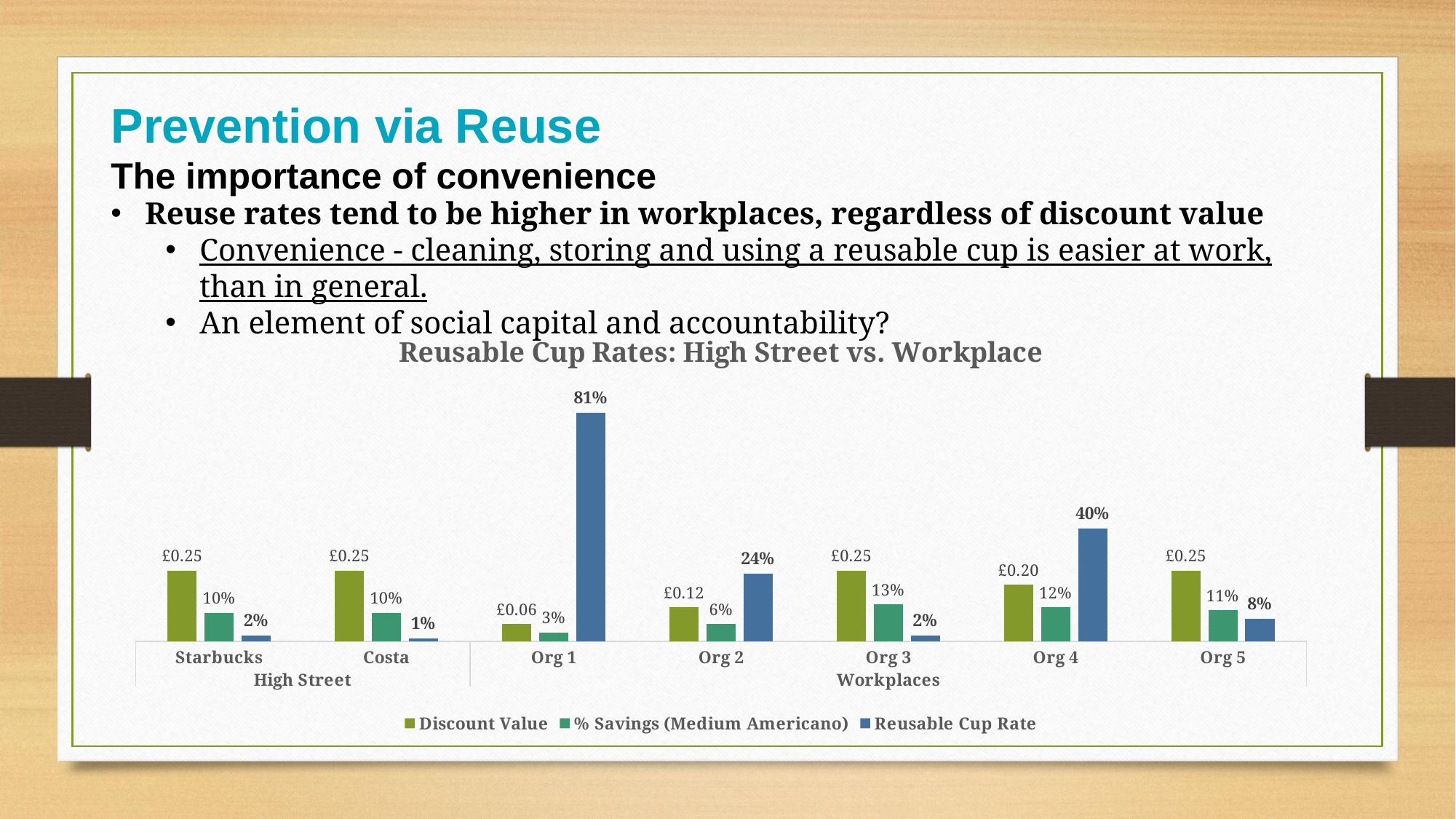
How many categories are shown on the x axis? 7 What is the difference between the Reusable Cup Rate for Org 1 and Org 4? 41% How many series does the legend list? 3 What is the Reusable Cup Rate for Org 1? 81% Which category has the lowest Discount Value? Org 1 What kind of chart is shown on the slide? Bar chart What is the title of the chart? Reusable Cup Rates: High Street vs. Workplace Which category has the highest Reusable Cup Rate? Org 1 What is the Reusable Cup Rate for Costa? 1% What is the Discount Value for Org 4? £0.20 What is the % Savings (Medium Americano) for Org 3? 13% Which has a higher Reusable Cup Rate, Org 2 or Org 5? Org 2